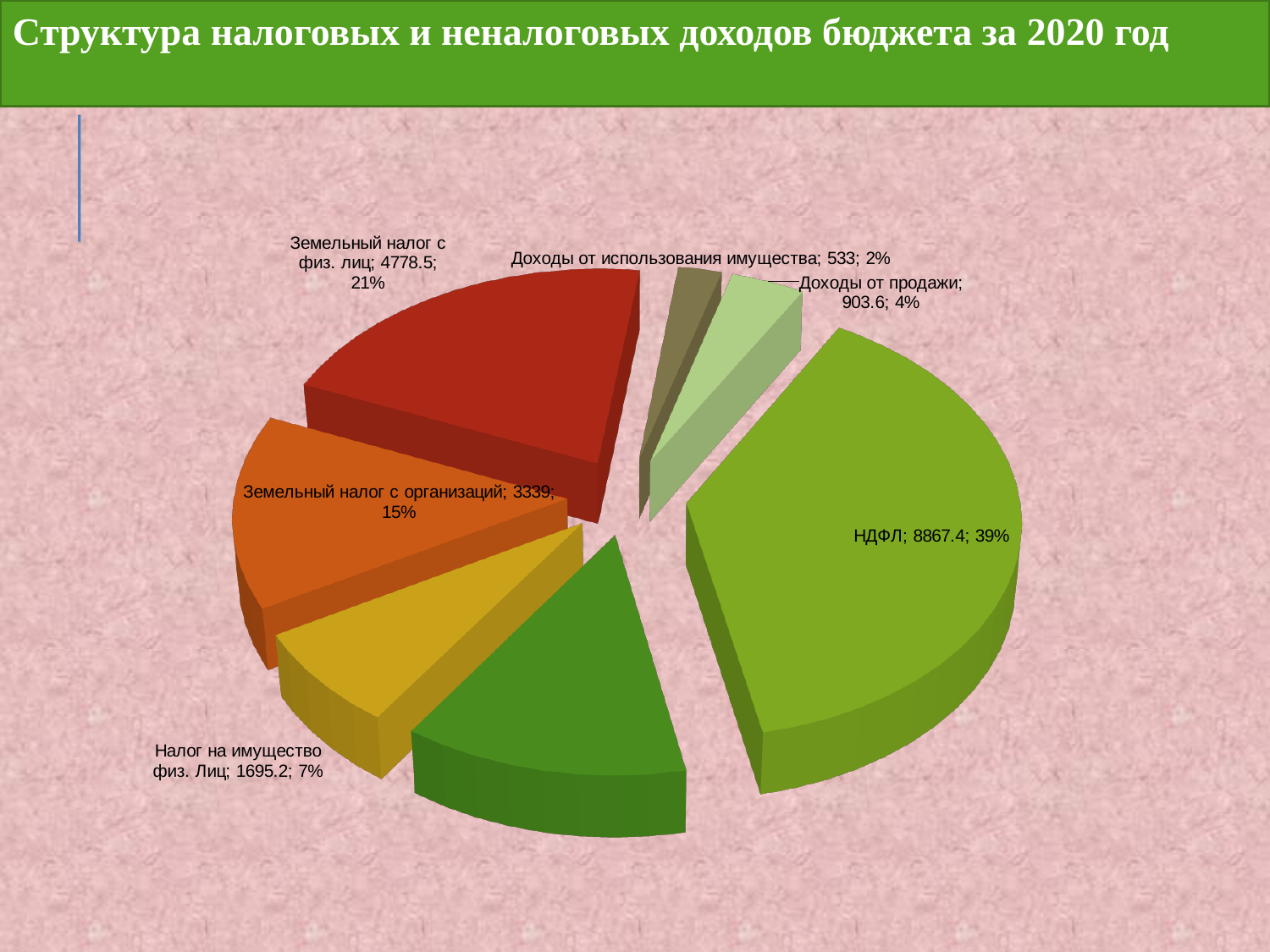
What share of the pie does НДФЛ represent? 39% Which category has the largest slice of the pie? НДФЛ What value is shown for Земельный налог с физ. лиц? 4778.5 What share of the pie does Земельный налог с организаций represent? 15% What value is shown for Налог на имущество физ. Лиц? 1695.2 What value is shown for Доходы от продажи? 903.6 What is the title of the slide? Структура налоговых и неналоговых доходов бюджета за 2020 год What kind of chart is shown on the slide? pie chart Which is larger, the value for Земельный налог с организаций or the value for Налог на имущество физ. Лиц? Земельный налог с организаций What value is shown for НДФЛ? 8867.4 What is the difference between the values for НДФЛ and Земельный налог с физ. лиц? 4088.9 Which labeled category has the smallest slice of the pie? Доходы от использования имущества